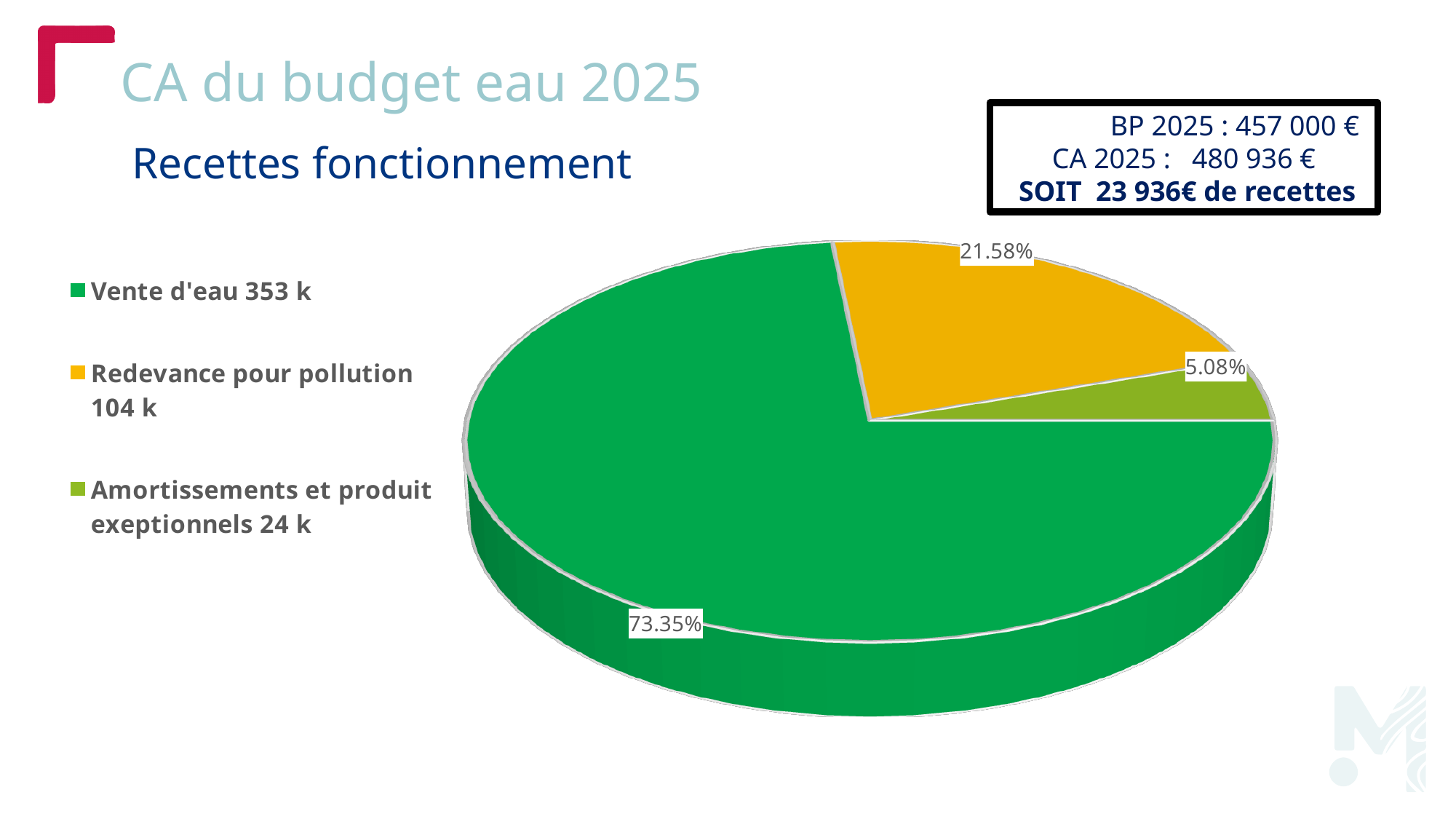
What colour is the Vente d'eau slice in the pie chart? green What is the difference in percentage points between the Redevance pour pollution slice and the Amortissements et produit exeptionnels slice? 16.50 Which category has the smallest slice of the pie? Amortissements et produit exeptionnels What share of the pie does the Amortissements et produit exeptionnels slice represent? 5.08% Which category has the largest slice of the pie? Vente d'eau Which slice is larger, Redevance pour pollution or Amortissements et produit exeptionnels? Redevance pour pollution What share of the pie does the Vente d'eau slice represent? 73.35% What share of the pie does the Redevance pour pollution slice represent? 21.58% What is the difference in percentage points between the Vente d'eau slice and the Redevance pour pollution slice? 51.77 What kind of chart is shown on the slide? pie chart What amount is shown in the legend for Redevance pour pollution? 104 k How many slices does the pie chart have? 3